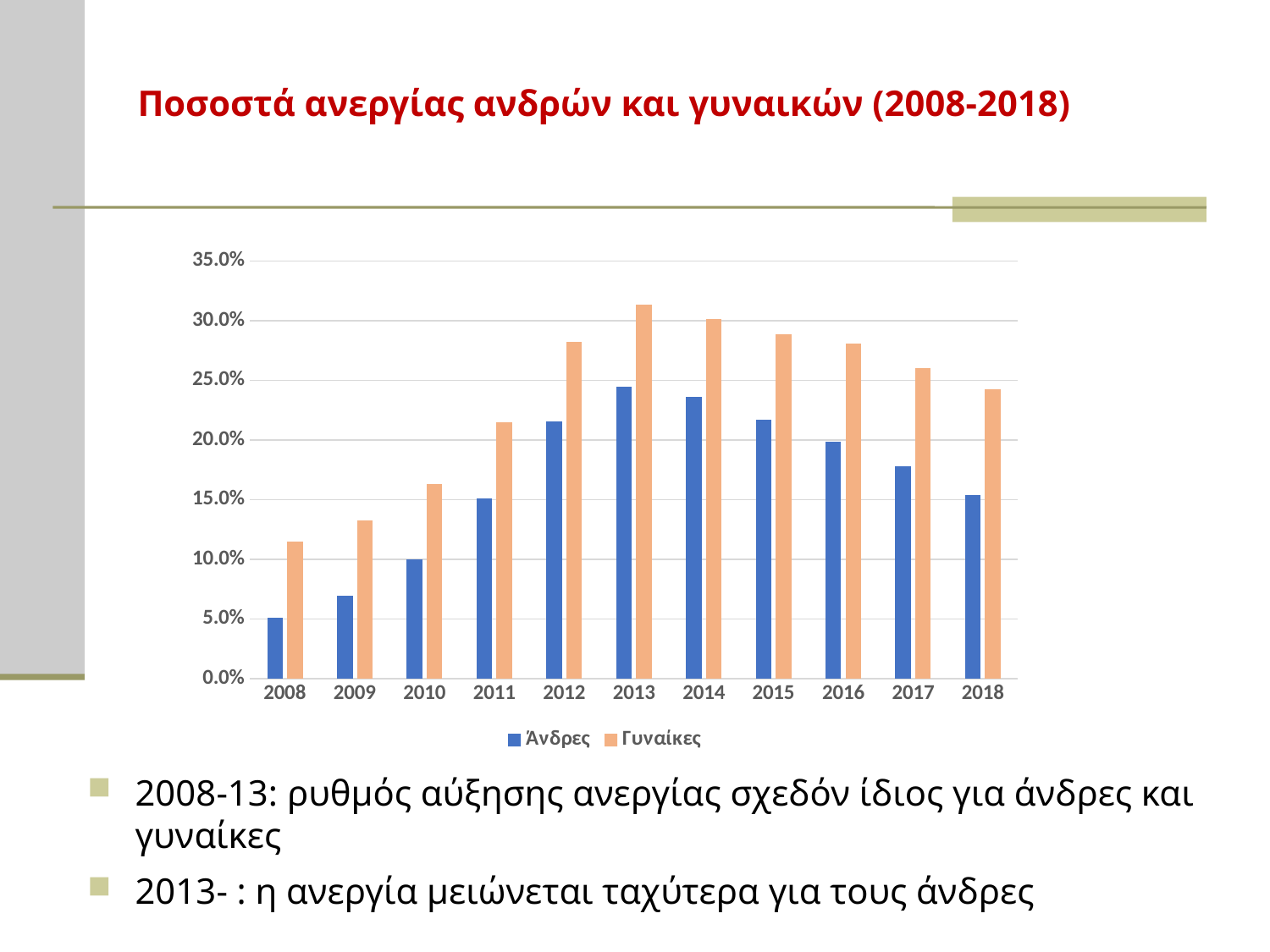
Which year has the highest value for Γυναίκες? 2013 Do the values for Άνδρες rise or fall from 2013 to 2018? fall Is the value for Άνδρες in 2017 greater or less than 15.0%? greater Is the value for Άνδρες in 2013 greater or less than 25.0%? less Which year has the lowest value for Άνδρες? 2008 In 2016, which series has the larger value, Άνδρες or Γυναίκες? Γυναίκες What kind of chart is shown on the slide? Bar chart How many years are shown on the x axis? 11 How many series does the legend list? 2 Is the value for Γυναίκες in 2013 greater or less than 30.0%? greater What is the title of the chart on the slide? Ποσοστά ανεργίας ανδρών και γυναικών (2008-2018) Which year has the highest value for Άνδρες? 2013